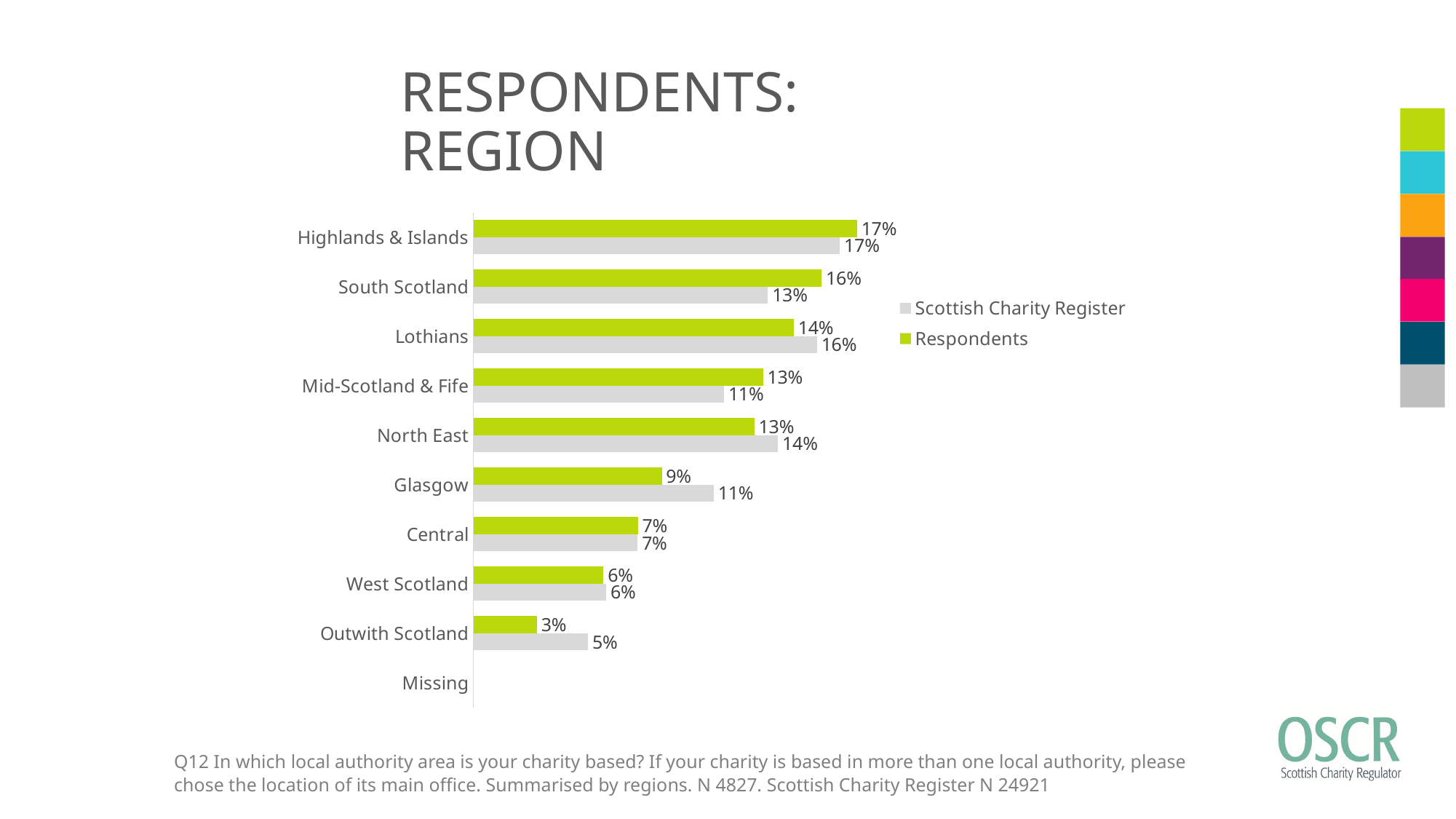
What is the Scottish Charity Register value for Outwith Scotland? 5% What type of chart is shown on the slide? bar chart What is the difference between the Respondents and Scottish Charity Register values for South Scotland? 3% What is the Scottish Charity Register value for Lothians? 16% How many series does the legend list? 2 Among the regions with plotted bars, which has the lowest Respondents value? Outwith Scotland Which region has the highest Respondents value? Highlands & Islands What is the Respondents value for Glasgow? 9% Which colour represents the Respondents series? green How many categories are listed on the vertical axis? 10 For Glasgow, which is larger: the Respondents value or the Scottish Charity Register value? Scottish Charity Register What is the Respondents value for South Scotland? 16%